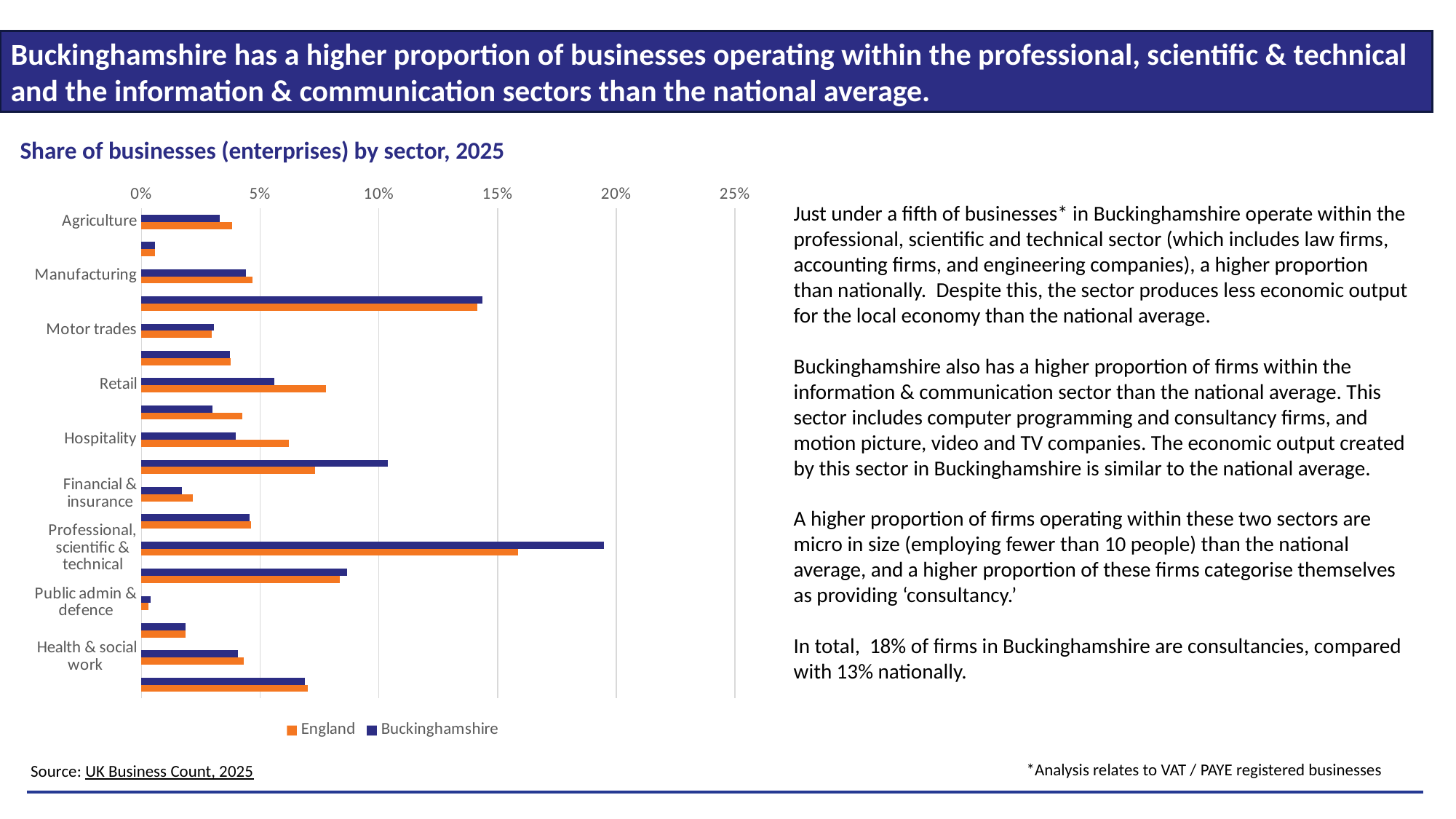
Which labelled sector has the highest share of businesses for Buckinghamshire? Professional, scientific & technical How many series does the chart legend list? 2 Is the England value for Retail greater or less than 5%? greater For Professional, scientific & technical, which is larger: the England value or the Buckinghamshire value? Buckinghamshire What kind of chart is shown on the slide? Bar chart Which colour represents Buckinghamshire in the chart? Blue For Retail, which is larger: the England value or the Buckinghamshire value? England Is the Buckinghamshire value for Hospitality greater or less than 5%? less Is the Buckinghamshire value for Professional, scientific & technical greater or less than 15%? greater What is the title of the chart? Share of businesses (enterprises) by sector, 2025 Which labelled sector has the lowest share of businesses for England? Public admin & defence